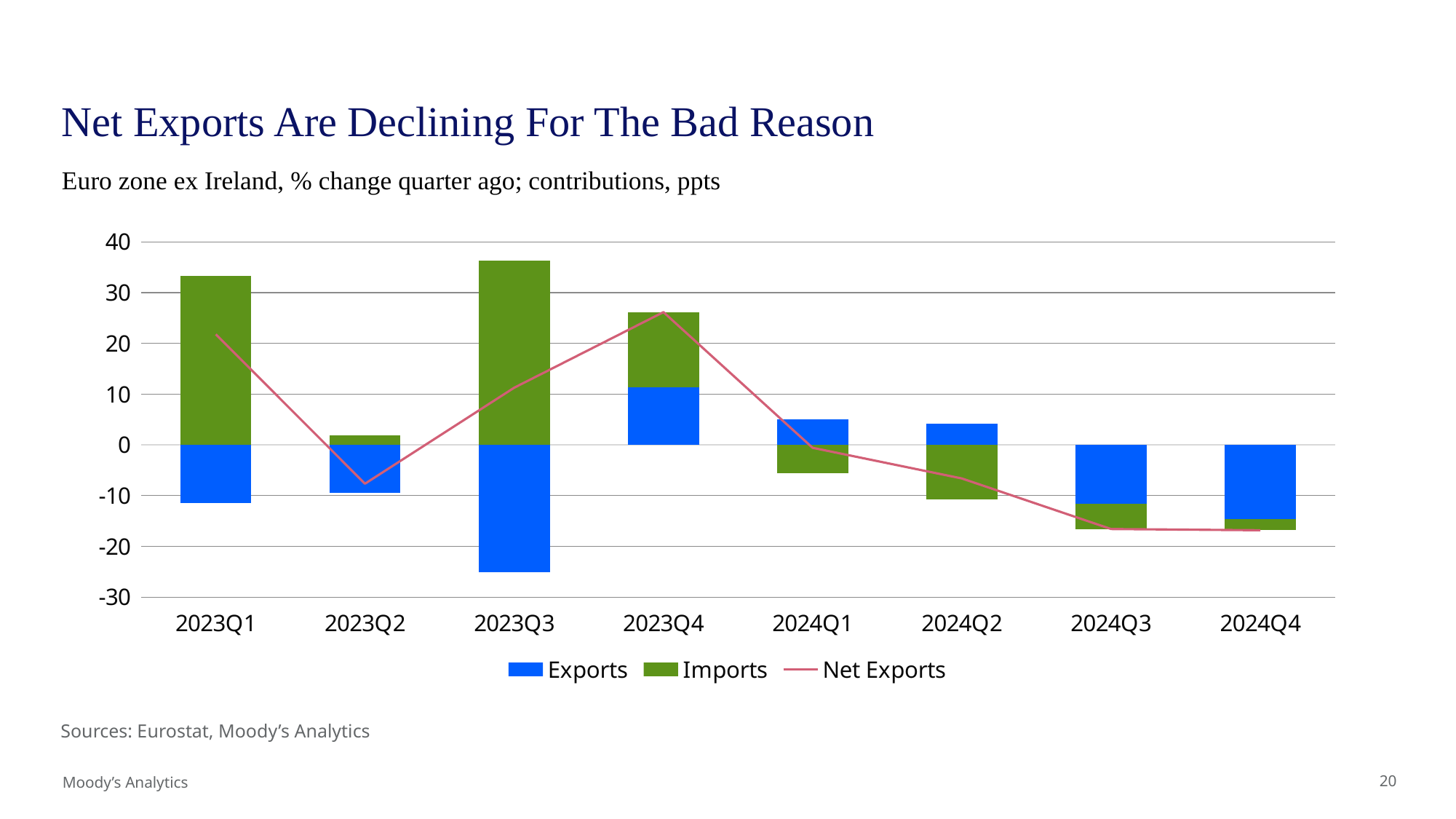
How many series does the legend list? 3 Which is larger, the Imports contribution in 2023Q1 or in 2023Q4? 2023Q1 What colour represents Imports in the chart? green What is the title of the chart? Net Exports Are Declining For The Bad Reason How many quarters are shown on the x axis? 8 In which quarter is the Net Exports line at its highest? 2023Q4 Is the Exports bar for 2023Q3 greater or less than -20? less Is the Net Exports value for 2023Q1 greater or less than 10? greater Does the Net Exports line rise or fall from 2023Q4 to 2024Q4? fall Is the Net Exports value for 2024Q3 greater or less than -10? less What kind of chart is shown on the slide? bar chart with a line